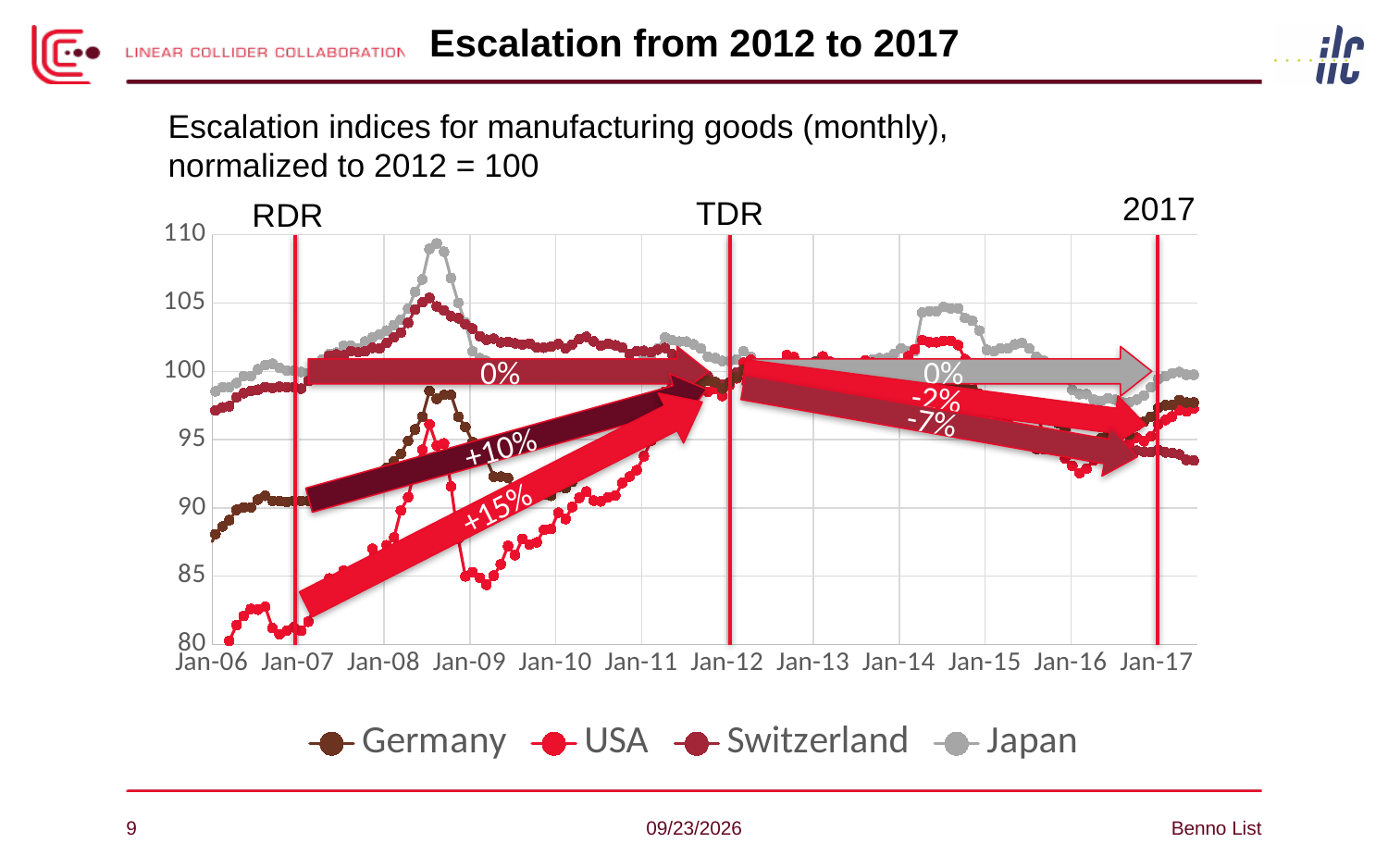
Which series are listed in the legend? Germany, USA, Switzerland, Japan Which series has the highest value at Jan-06? Japan What are the labels of the three vertical red lines on the chart? RDR, TDR, 2017 Does the USA series rise or fall between Jan-07 and Jan-12? rise At Jan-06, which is larger: the value for Switzerland or the value for Germany? Switzerland Which series has the lowest value at Jan-06? USA Is the value for Japan at Jan-06 greater or less than 95? greater Is the value for USA at Jan-06 greater or less than 85? less What kind of chart is shown on the slide? line chart Is the value for Germany at Jan-06 greater or less than 90? less How many series does the legend list? 4